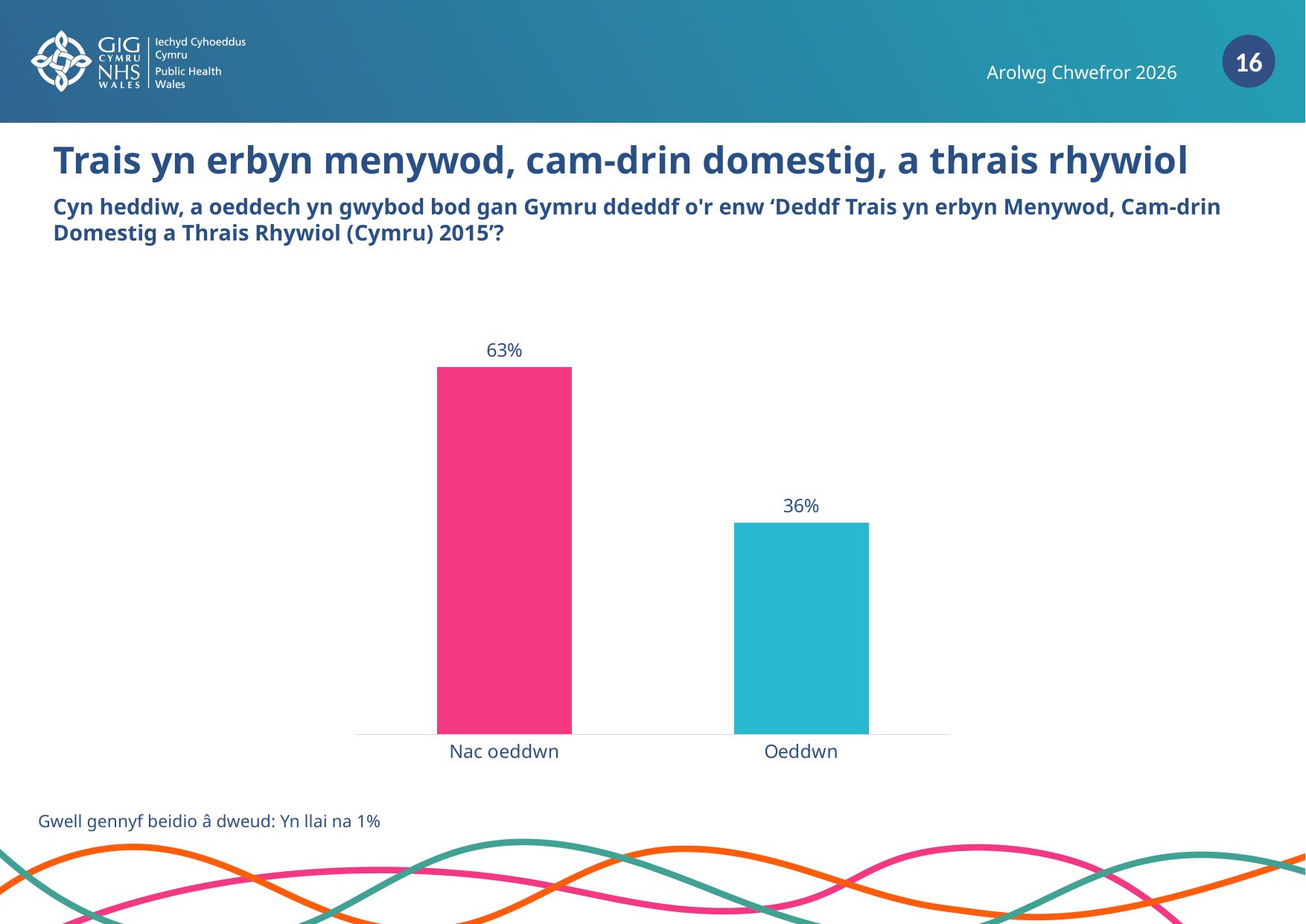
What kind of chart is shown on the slide? Bar chart How many categories are shown in the chart? 2 Which category has the lowest value? Oeddwn Which is larger, the value for Nac oeddwn or the value for Oeddwn? Nac oeddwn What is the value for Nac oeddwn? 63% Which category has the highest value? Nac oeddwn What is the value for Oeddwn? 36% What is the difference between the values for Nac oeddwn and Oeddwn? 27% What is the total of the two bar values shown? 99% What colour is the bar for Nac oeddwn? Pink What colour is the bar for Oeddwn? Blue